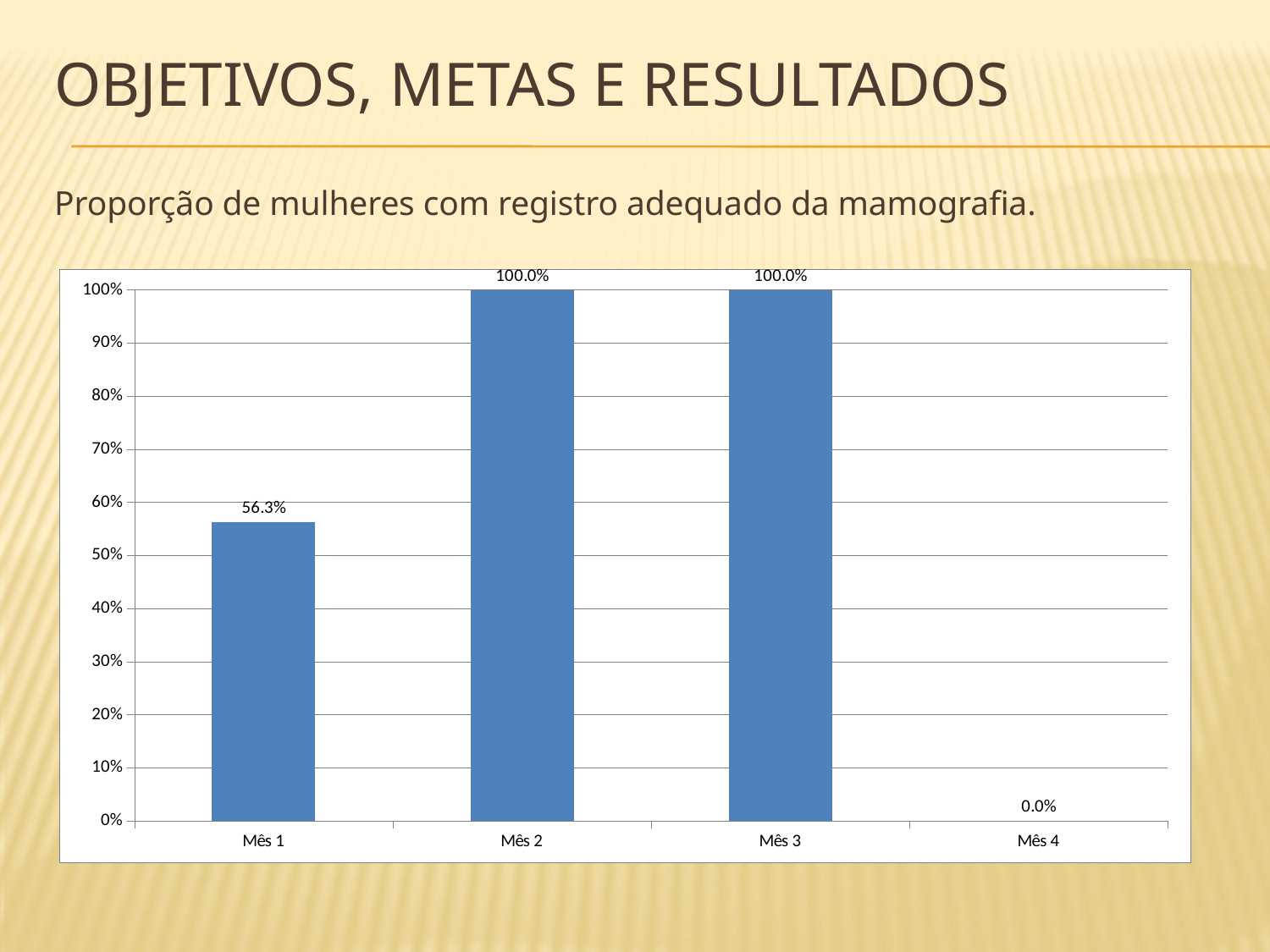
Which category has the lowest value? Mês 4 What is the value for Mês 4? 0.0% What is the difference between the values for Mês 2 and Mês 1? 43.7% What is the value for Mês 1? 56.3% How many categories are shown on the x axis? 4 What is the value for Mês 2? 100.0% Is the value for Mês 1 greater or less than 50%? greater What colour are the bars in the chart? blue Which is larger, the value for Mês 1 or the value for Mês 3? Mês 3 What is the text above the chart describing what it shows? Proporção de mulheres com registro adequado da mamografia. What kind of chart is shown on the slide? bar chart Do the values rise or fall from Mês 1 to Mês 2? rise